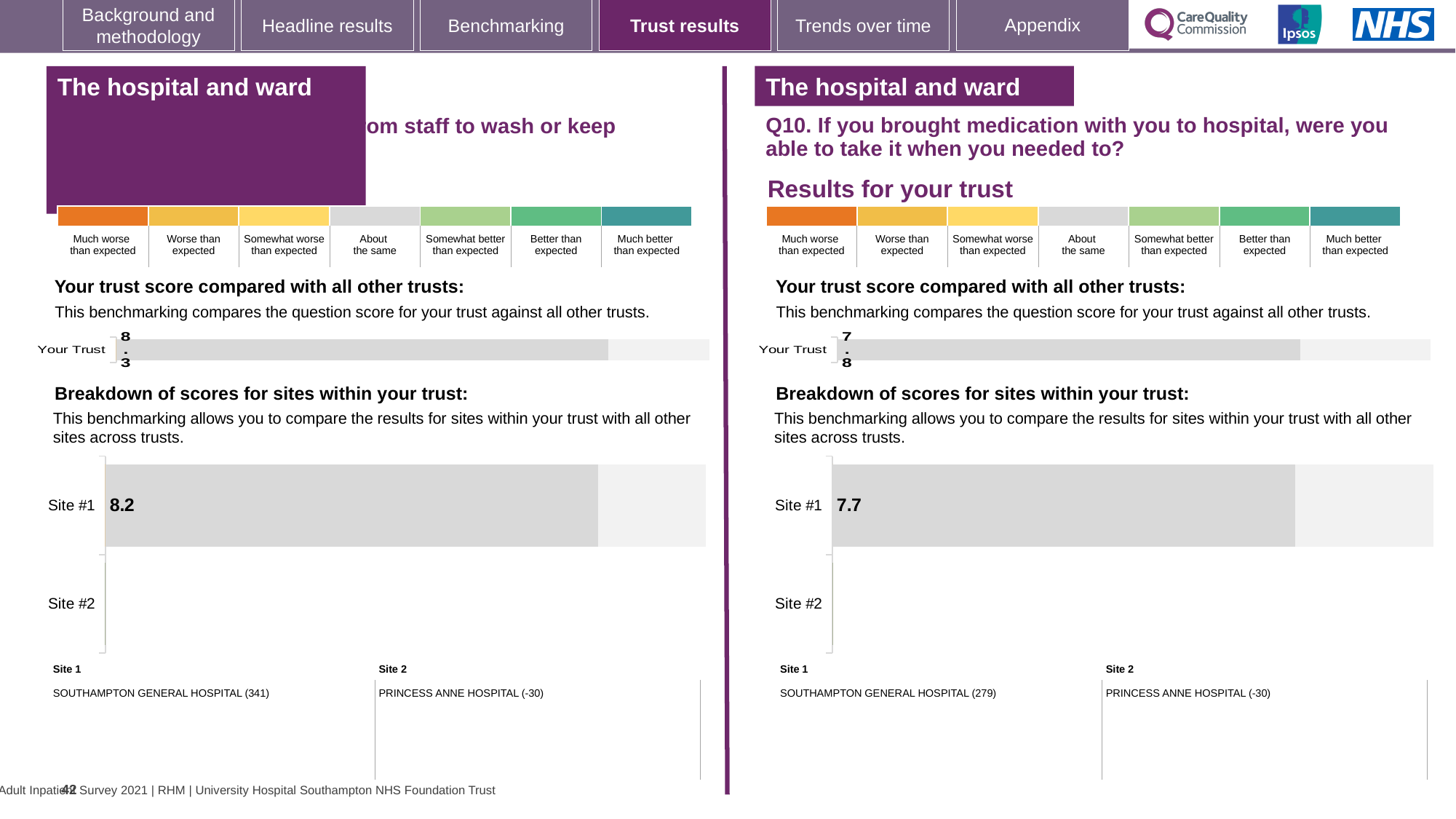
Which side of the slide shows the higher Site #1 score, the left chart or the right (Q10) chart? Left What is the difference between the Site #1 score on the left chart (8.2) and the Site #1 score on the right Q10 chart (7.7)? 0.5 According to the key below the right-hand Q10 chart, which hospital is Site 1? SOUTHAMPTON GENERAL HOSPITAL (279) On the left-hand side of the slide, what is the score shown for Your Trust in the 'Your trust score compared with all other trusts' chart? 8.3 What type of chart is used to show the Site #1 and Site #2 scores on the right-hand side (Q10)? Bar chart On the right-hand side (Q10), which site has a bar plotted in the 'Breakdown of scores for sites within your trust' chart? Site #1 How many sites are listed on the axis of the 'Breakdown of scores for sites within your trust' chart on the right-hand side (Q10)? 2 On the right-hand side of the slide (Q10), what is the score shown for Your Trust in the 'Your trust score compared with all other trusts' chart? 7.8 What is the difference between the Your Trust score on the left chart (8.3) and the Your Trust score on the right Q10 chart (7.8)? 0.5 On the left-hand side, is the Your Trust score greater or less than the Site #1 score? greater On the right-hand side of the slide (Q10), what is the score shown for Site #1 in the 'Breakdown of scores for sites within your trust' chart? 7.7 On the left-hand side of the slide, what is the score shown for Site #1 in the 'Breakdown of scores for sites within your trust' chart? 8.2